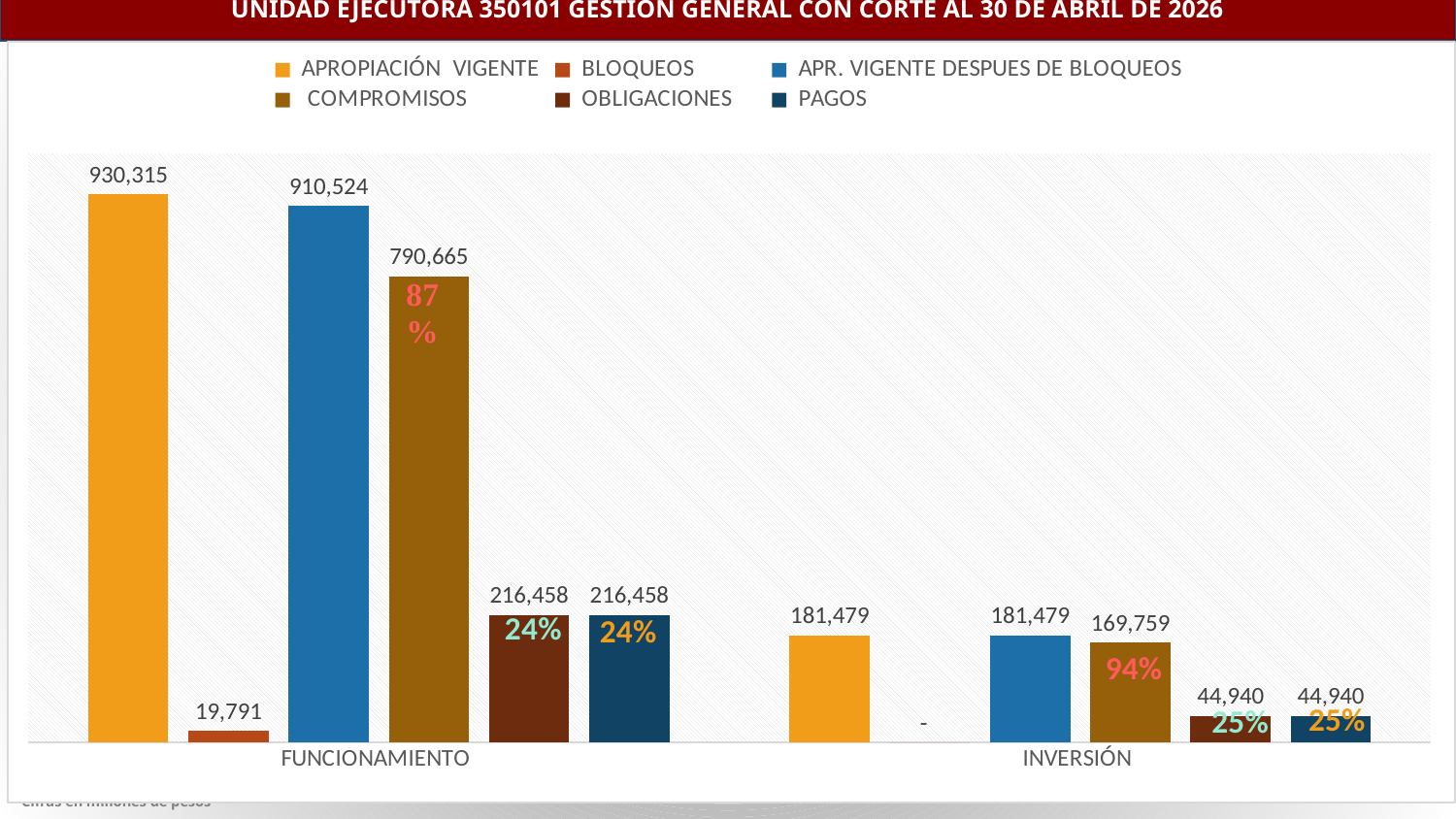
What is the value of APROPIACIÓN VIGENTE for FUNCIONAMIENTO? 930,315 Which is larger: COMPROMISOS for FUNCIONAMIENTO or COMPROMISOS for INVERSIÓN? COMPROMISOS for FUNCIONAMIENTO What is the difference between APROPIACIÓN VIGENTE and APR. VIGENTE DESPUES DE BLOQUEOS for FUNCIONAMIENTO? 19,791 Which series has the lowest value for FUNCIONAMIENTO? BLOQUEOS What kind of chart is shown on the slide? Bar chart What percentage is shown on the COMPROMISOS bar for FUNCIONAMIENTO? 87% What is the value of BLOQUEOS for FUNCIONAMIENTO? 19,791 What is the value of PAGOS for INVERSIÓN? 44,940 What percentage is shown on the OBLIGACIONES bar for INVERSIÓN? 25% What is the value of COMPROMISOS for INVERSIÓN? 169,759 Which series has the highest value for FUNCIONAMIENTO? APROPIACIÓN VIGENTE How many series does the legend list? 6